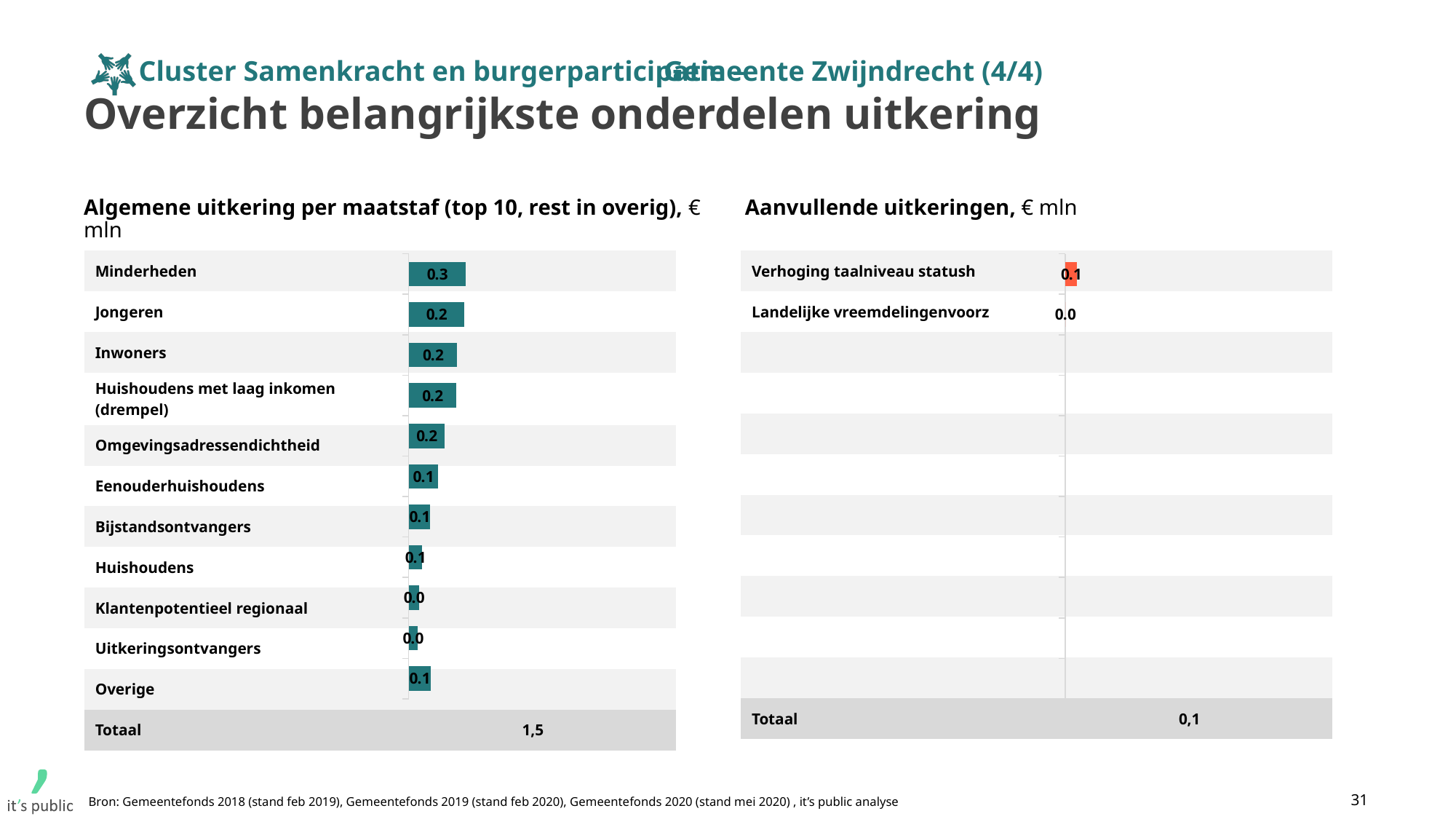
In the chart 'Algemene uitkering per maatstaf', what is the value for Omgevingsadressendichtheid? 0.2 How many categories are shown in the chart 'Algemene uitkering per maatstaf'? 11 How many categories are shown in the chart 'Aanvullende uitkeringen'? 2 In the chart 'Algemene uitkering per maatstaf', what is the value for Klantenpotentieel regionaal? 0.0 In the chart 'Algemene uitkering per maatstaf', which category has the highest value? Minderheden In the chart 'Algemene uitkering per maatstaf', what is the value for Minderheden? 0.3 In the chart 'Algemene uitkering per maatstaf', what is the difference between the values for Minderheden and Eenouderhuishoudens? 0.2 In the chart 'Aanvullende uitkeringen', what is the value for Verhoging taalniveau statush? 0.1 What is the Totaal shown for the chart 'Algemene uitkering per maatstaf'? 1,5 In the chart 'Aanvullende uitkeringen', what is the value for Landelijke vreemdelingenvoorz? 0.0 In the chart 'Algemene uitkering per maatstaf', which is larger: the value for Jongeren or the value for Bijstandsontvangers? Jongeren What kind of chart is the chart 'Algemene uitkering per maatstaf'? Bar chart